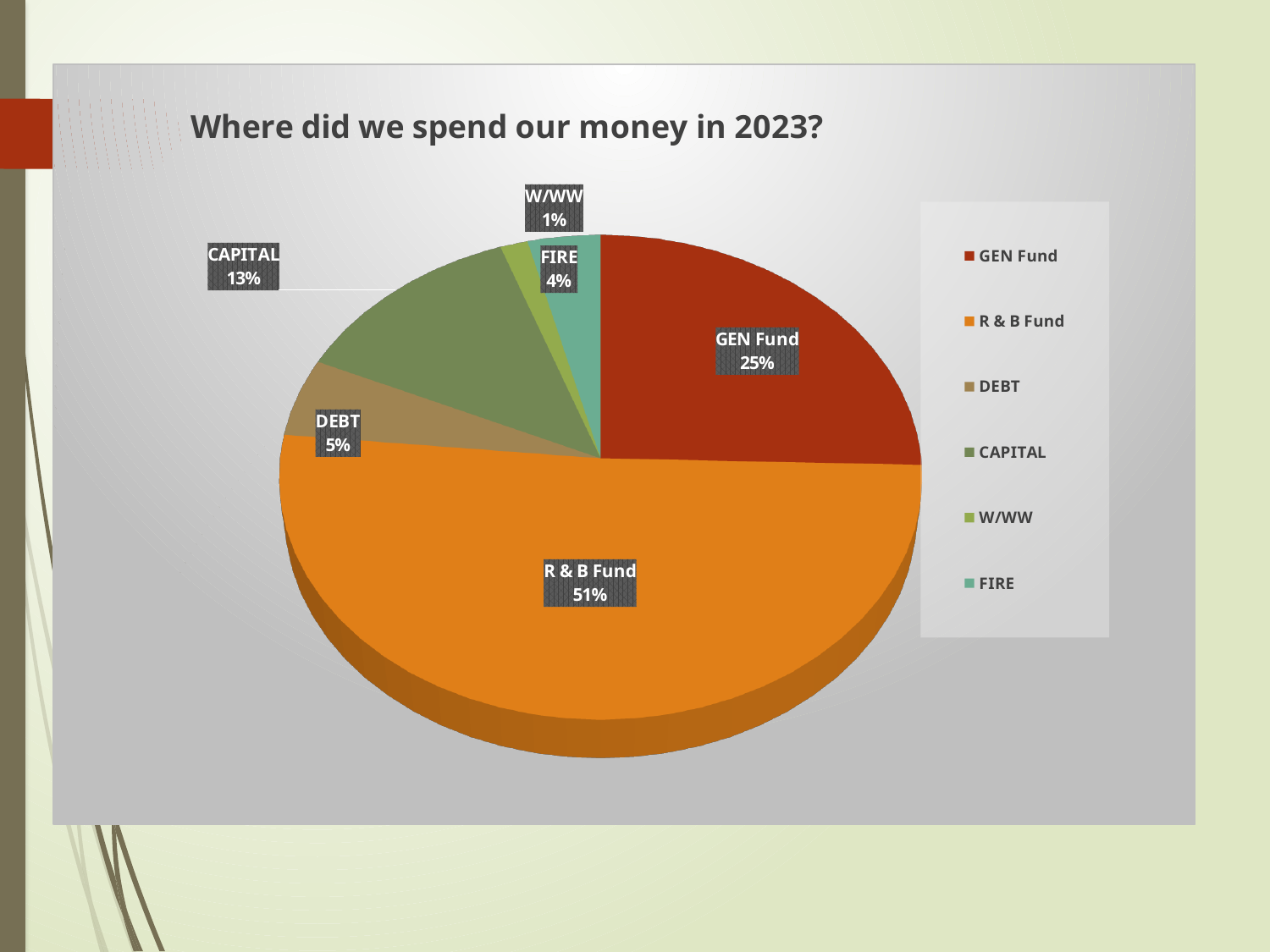
Which category has the smallest slice of the pie? W/WW What share of spending went to the R & B Fund? 51% Which category has the largest slice of the pie? R & B Fund What share of spending went to the GEN Fund? 25% What percentage is shown for FIRE? 4% What percentage is shown for DEBT? 5% What percentage is shown for CAPITAL? 13% Which is larger, the CAPITAL slice or the DEBT slice? CAPITAL What kind of chart is shown on the slide? pie chart What percentage is shown for W/WW? 1% How many categories does the legend list? 6 What is the difference in percentage points between the R & B Fund and the GEN Fund? 26